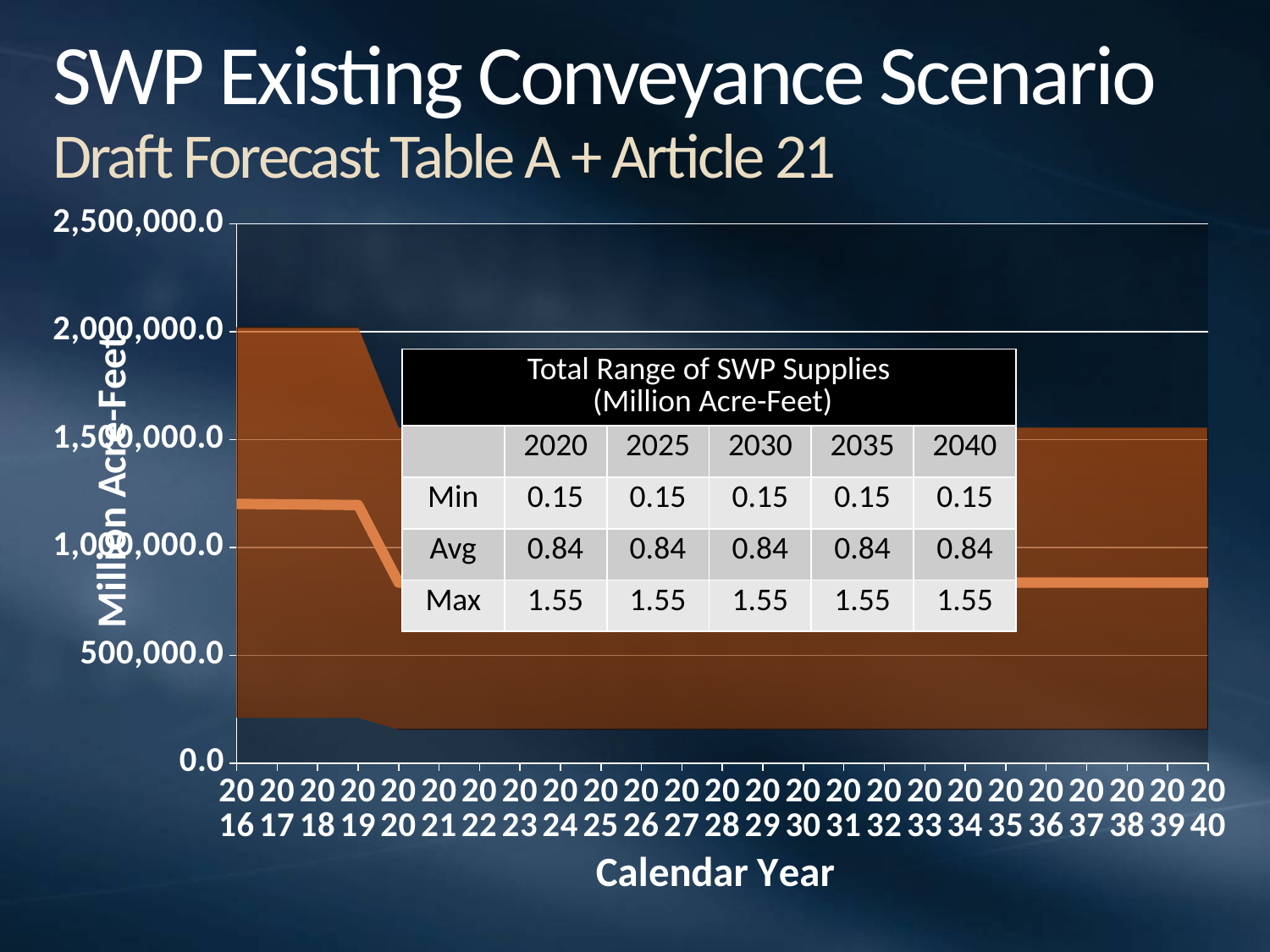
How many calendar years are shown on the x axis? 25 What is the title of the table overlaid on the chart? Total Range of SWP Supplies (Million Acre-Feet) According to the table, what is the Max value for 2040? 1.55 According to the table, what is the difference between the Max and Min values for 2025? 1.40 Does the average line rise or fall from 2016 to 2040? fall What is the x-axis title of the chart? Calendar Year Is the value of the average line in 2016 greater or less than 1,000,000.0? greater Is the value of the average line in 2040 greater or less than 1,000,000.0? less According to the table, what is the Min value for 2020? 0.15 Is the top of the shaded range in 2030 greater or less than 2,000,000.0? less According to the table, what is the Avg value for 2030? 0.84 According to the table, which is larger for 2035: the Max value or the Avg value? Max